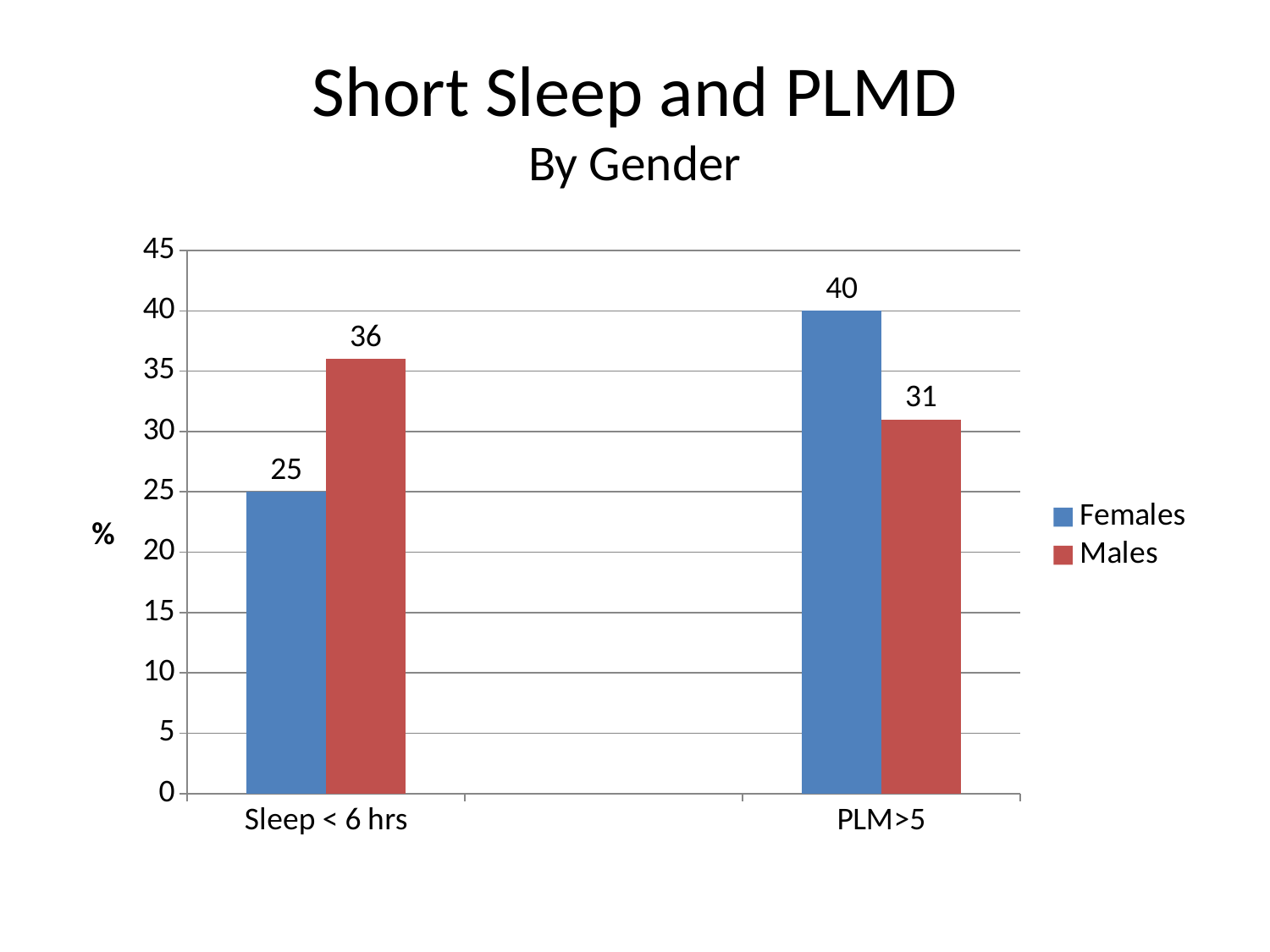
What is the difference between Females and Males in the PLM>5 category? 9 What is the value for Females in the Sleep < 6 hrs category? 25 What is the value for Males in the Sleep < 6 hrs category? 36 How many series does the legend list? 2 Which bar has the lowest value on the chart? Females, Sleep < 6 hrs What is the value for Females in the PLM>5 category? 40 What kind of chart is shown on the slide? Bar chart In the PLM>5 category, which is larger, Females or Males? Females What is the value for Males in the PLM>5 category? 31 How many categories are shown on the x axis? 2 What is the difference between Males and Females in the Sleep < 6 hrs category? 11 Which bar has the highest value on the chart? Females, PLM>5